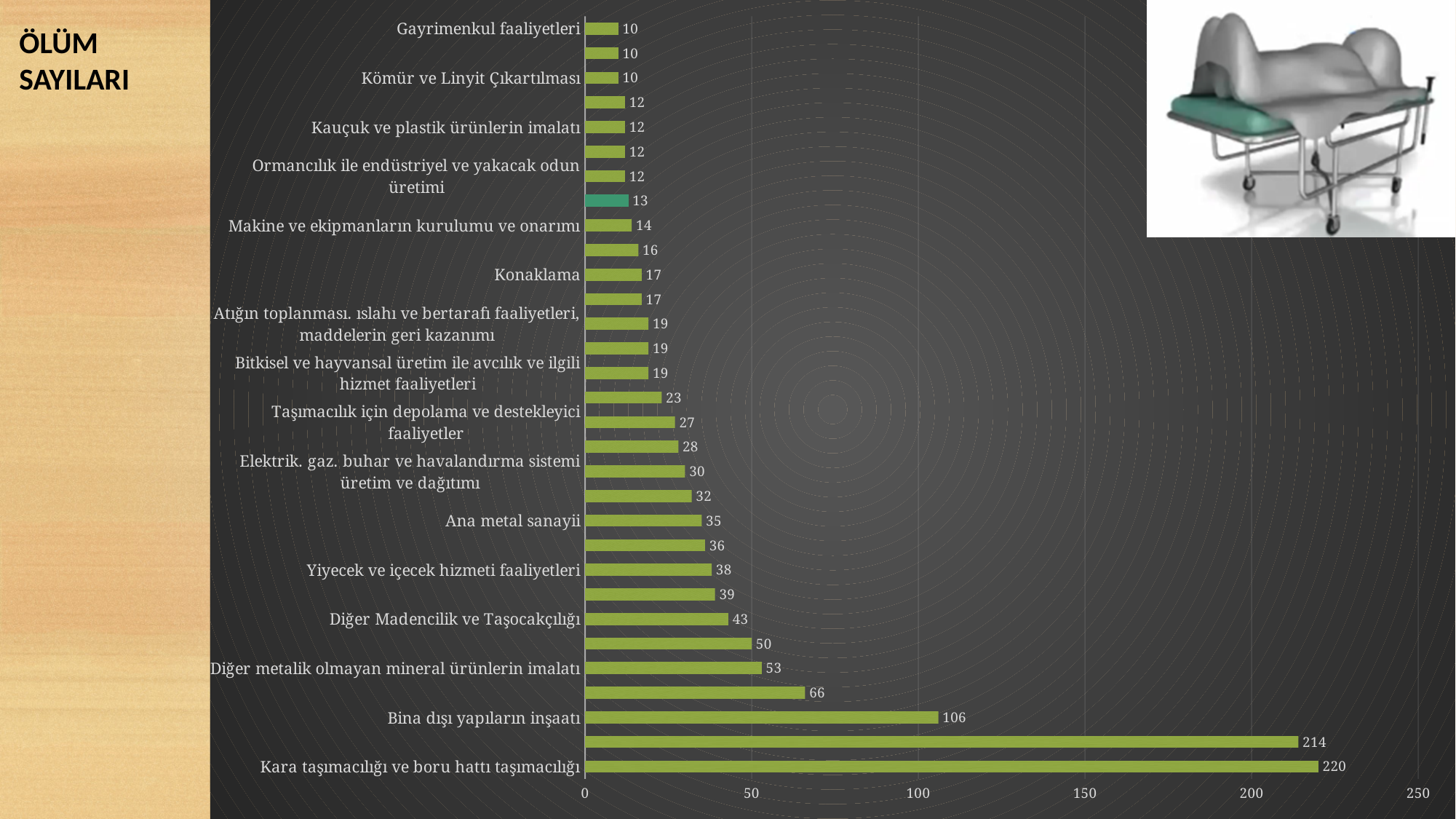
What is the title shown on the slide? ÖLÜM SAYILARI What is the value for Konaklama? 17 Which category has the highest value? Kara taşımacılığı ve boru hattı taşımacılığı What is the value for Diğer Madencilik ve Taşocakçılığı? 43 What kind of chart is shown on the slide? bar chart What is the lowest value shown on the chart? 10 What is the value for Bina dışı yapıların inşaatı? 106 What is the difference between the values for Kara taşımacılığı ve boru hattı taşımacılığı and Bina dışı yapıların inşaatı? 114 Is the value for Bina dışı yapıların inşaatı greater or less than 100? greater What is the value for Ana metal sanayii? 35 Which is larger, the value for Ana metal sanayii or the value for Konaklama? Ana metal sanayii What is the value for Kara taşımacılığı ve boru hattı taşımacılığı? 220